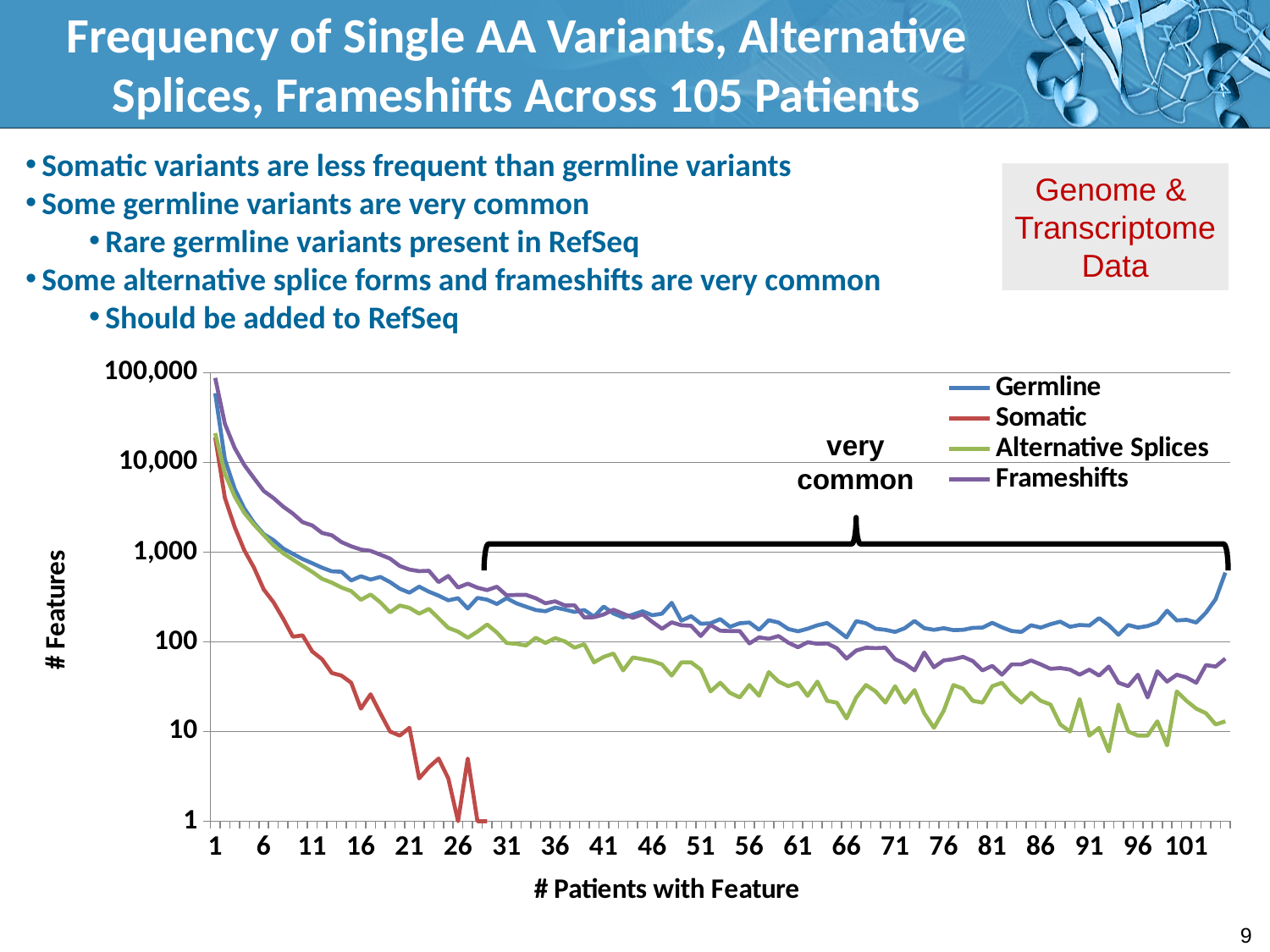
At 51 patients, which series has the higher value, Germline or Alternative Splices? Germline Is the value for Alternative Splices at 91 patients greater or less than 100? less What is the title of the x axis of the chart? # Patients with Feature Does the Somatic series rise or fall as the number of patients increases? Fall Is the value for Germline at 51 patients greater or less than 100? greater How many series does the chart legend list? 4 Is the value for Somatic at 11 patients greater or less than 1,000? less What kind of chart is shown on the slide? Line chart What is the title of the y axis of the chart? # Features Which series has the lowest value at 21 patients? Somatic